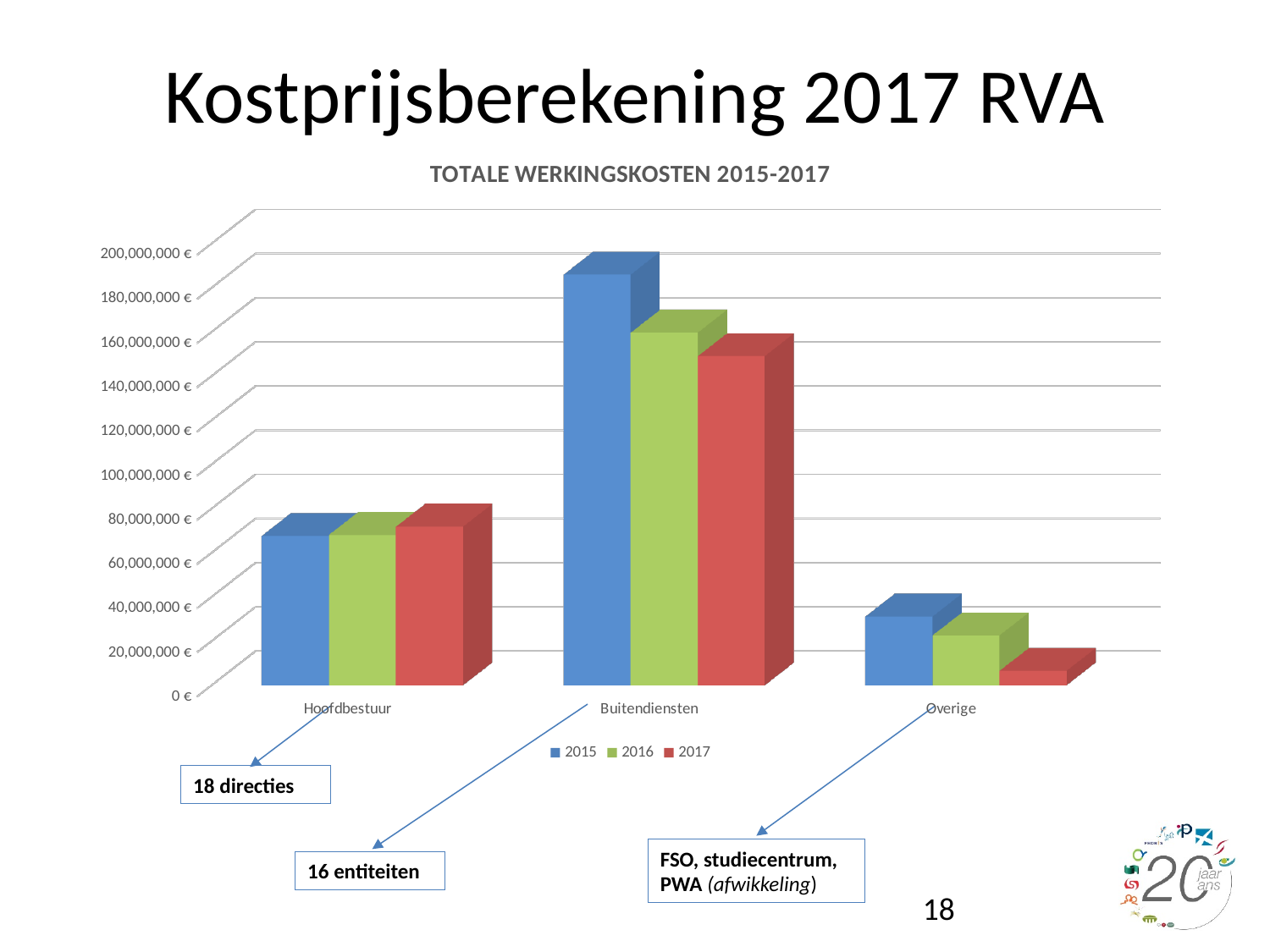
What is the title of the chart? TOTALE WERKINGSKOSTEN 2015-2017 How many categories are shown on the x axis? 3 Is the value for Buitendiensten in 2015 greater or less than 160,000,000 €? greater How many series does the legend list? 3 Which category has the highest value for 2015? Buitendiensten Is the value for Hoofdbestuur in 2016 greater or less than 100,000,000 €? less For Overige, which is larger: the 2016 value or the 2017 value? 2016 For Buitendiensten, which is larger: the 2015 value or the 2016 value? 2015 Do the values for Overige rise or fall from 2015 to 2017? fall What type of chart is shown on the slide? bar chart Which category has the lowest value for 2017? Overige Is the value for Overige in 2017 greater or less than 20,000,000 €? less